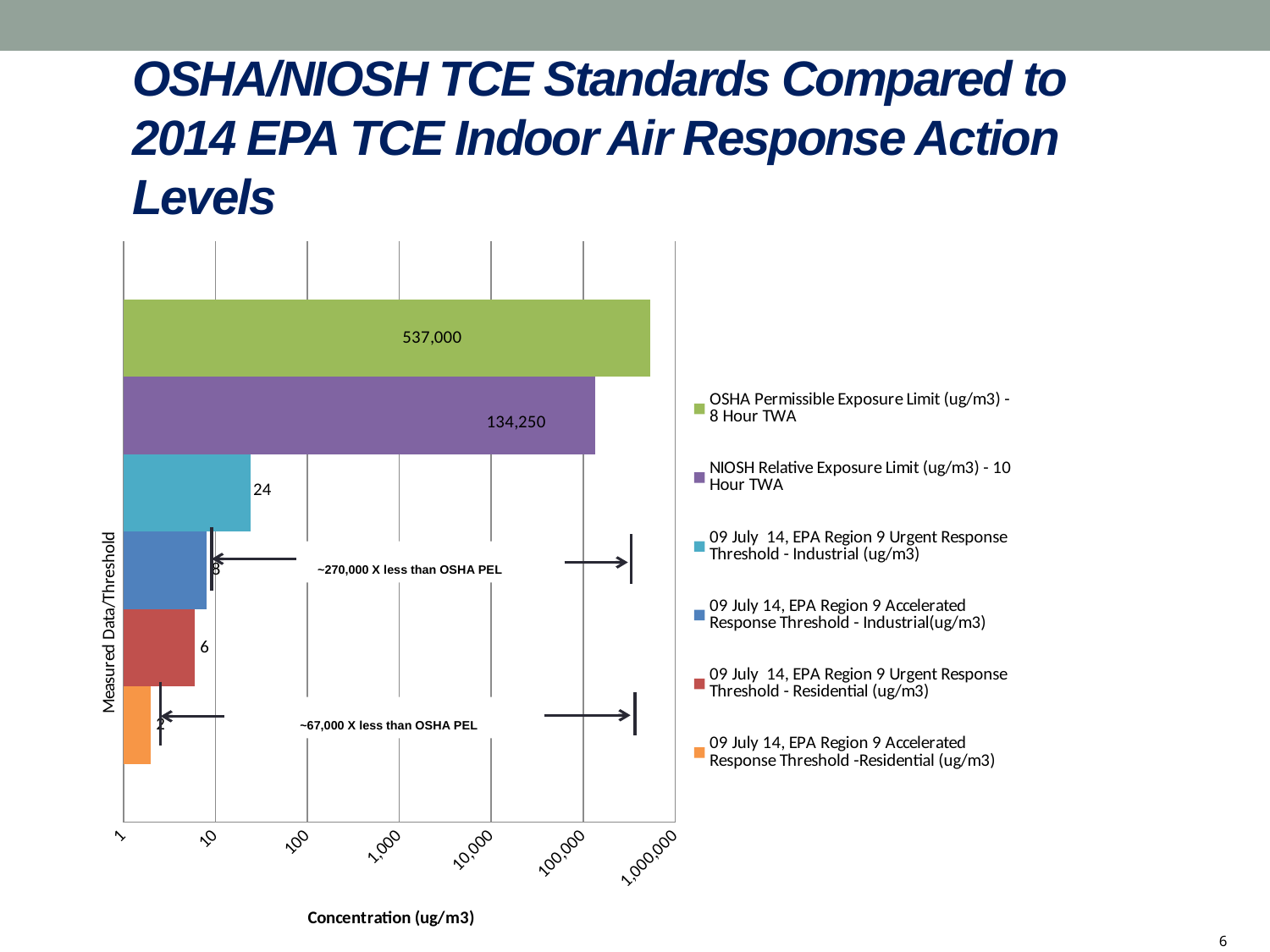
What is the value for the NIOSH Relative Exposure Limit (ug/m3) - 10 Hour TWA? 134,250 What is the value for the 09 July 14, EPA Region 9 Urgent Response Threshold - Industrial (ug/m3)? 24 What is the title of the x axis? Concentration (ug/m3) What is the value for the OSHA Permissible Exposure Limit (ug/m3) - 8 Hour TWA? 537,000 What is the value for the 09 July 14, EPA Region 9 Urgent Response Threshold - Residential (ug/m3)? 6 How many series does the legend list? 6 Is the value for the 09 July 14, EPA Region 9 Accelerated Response Threshold - Industrial (ug/m3) greater or less than 10? less Which is larger, the OSHA Permissible Exposure Limit or the NIOSH Relative Exposure Limit? OSHA Permissible Exposure Limit What is the difference between the OSHA Permissible Exposure Limit and the NIOSH Relative Exposure Limit? 402,750 What kind of chart is shown on the slide? bar chart Which series has the lowest value? 09 July 14, EPA Region 9 Accelerated Response Threshold -Residential (ug/m3) Which series has the highest value? OSHA Permissible Exposure Limit (ug/m3) - 8 Hour TWA